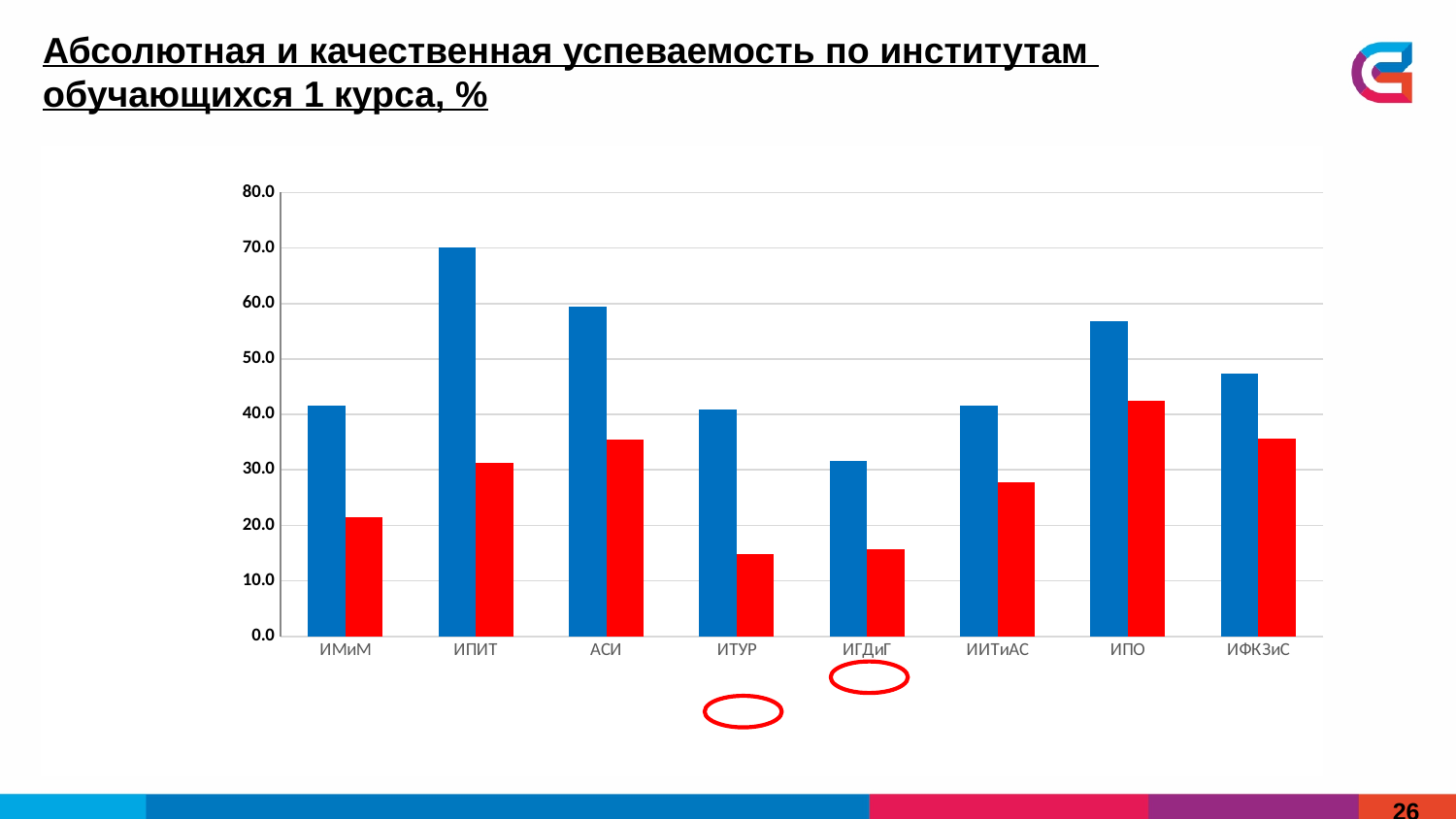
Is the red bar for ИПО greater or less than 40.0? greater Which has the larger blue bar, ИПИТ or АСИ? ИПИТ Which institute has the tallest blue bar? ИПИТ How many institutes (categories) are shown on the x axis? 8 What kind of chart is shown on the slide? bar chart Which has the larger red bar, АСИ or ИМиМ? АСИ Is the blue bar for ИГДиГ greater or less than 40.0? less Which institute has the shortest blue bar? ИГДиГ Is the red bar for ИТУР greater or less than 20.0? less Which institute has the tallest red bar? ИПО What is the highest value shown on the vertical axis? 80.0